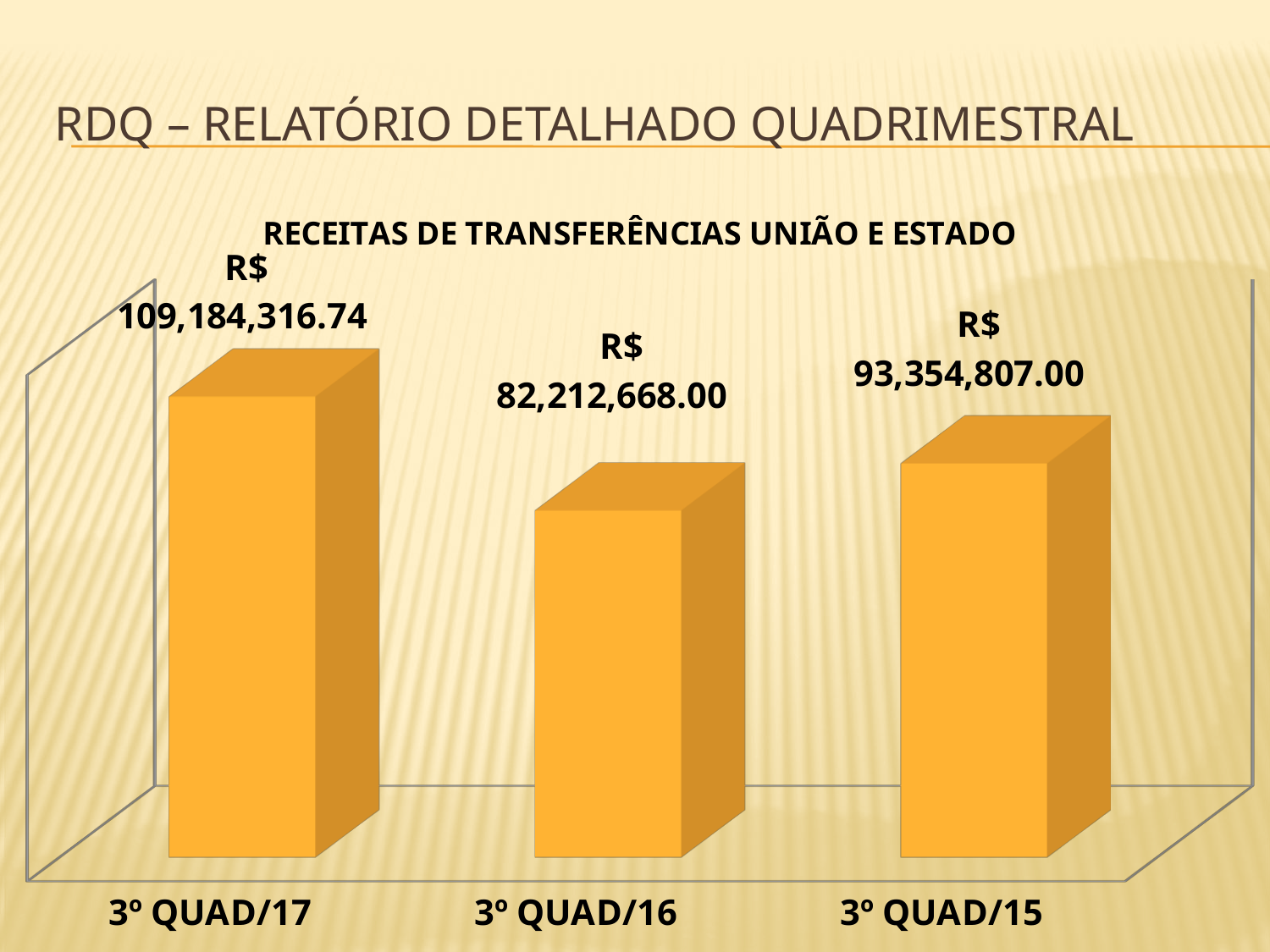
Does the value rise or fall from 3º QUAD/17 to 3º QUAD/16? Fall What is the value for 3º QUAD/17? R$ 109,184,316.74 What is the difference between the values for 3º QUAD/15 and 3º QUAD/16? R$ 11,142,139.00 How many categories are shown in the chart? 3 Which category has the highest value? 3º QUAD/17 What is the difference between the values for 3º QUAD/17 and 3º QUAD/16? R$ 26,971,648.74 What kind of chart is shown on the slide? Bar chart What is the value for 3º QUAD/15? R$ 93,354,807.00 Which is larger, the value for 3º QUAD/15 or the value for 3º QUAD/16? 3º QUAD/15 Which category has the lowest value? 3º QUAD/16 What is the value for 3º QUAD/16? R$ 82,212,668.00 What is the title of the chart? RECEITAS DE TRANSFERÊNCIAS UNIÃO E ESTADO